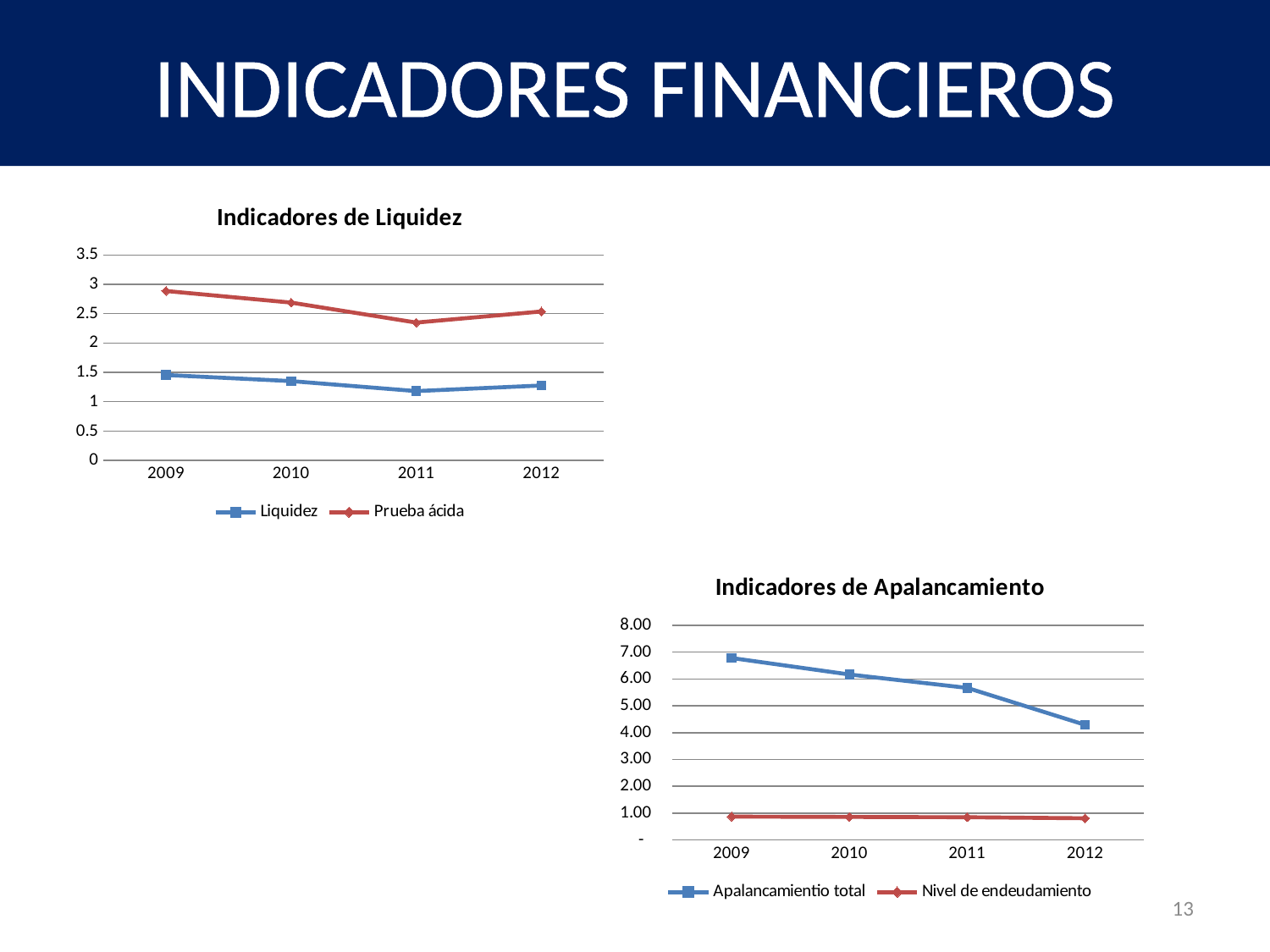
In 'Indicadores de Liquidez', is the value for Prueba ácida in 2009 greater or less than 2.5? greater In 'Indicadores de Apalancamiento', which year has the lowest value for Apalancamiento total? 2012 What are the two series listed in the legend of 'Indicadores de Liquidez'? Liquidez and Prueba ácida How many years are shown on the x axis of 'Indicadores de Liquidez'? 4 In 'Indicadores de Apalancamiento', which year has the highest value for Apalancamiento total? 2009 What kind of chart is 'Indicadores de Liquidez'? line chart In 'Indicadores de Liquidez', which year has the lowest value for Prueba ácida? 2011 In 'Indicadores de Apalancamiento', does the Apalancamiento total series rise or fall from 2009 to 2012? fall How many series does the legend of 'Indicadores de Apalancamiento' list? 2 In 'Indicadores de Liquidez', which series has the larger value in 2010, Liquidez or Prueba ácida? Prueba ácida In 'Indicadores de Apalancamiento', is the value for Apalancamiento total in 2012 greater or less than 5.00? less In 'Indicadores de Apalancamiento', is the value for Nivel de endeudamiento in 2009 greater or less than 1.00? less